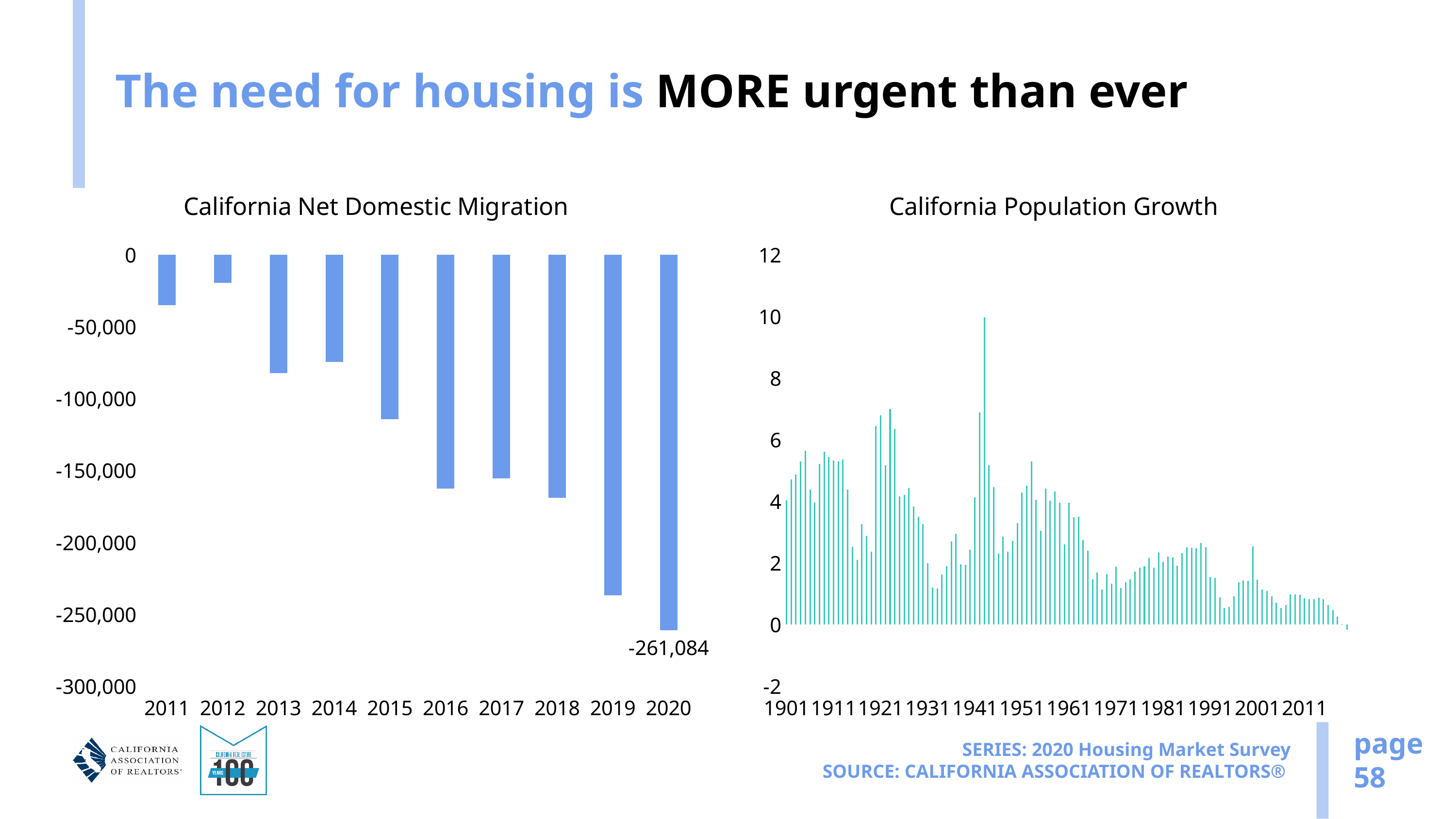
In the California Population Growth chart, is the value for 1901 greater or less than 2? greater What kind of chart is the California Population Growth chart? Bar chart In the California Net Domestic Migration chart, is the value for 2019 greater or less than -200,000? less What kind of chart is the California Net Domestic Migration chart? Bar chart What is the title of the chart on the right side of the slide? California Population Growth In the California Net Domestic Migration chart, is the value for 2013 greater or less than -100,000? greater In the California Net Domestic Migration chart, which year has the lower value, 2015 or 2016? 2016 In the California Net Domestic Migration chart, what is the value for 2020? -261,084 In the California Net Domestic Migration chart, which year has the lowest (most negative) value? 2020 In the California Net Domestic Migration chart, do the values generally rise or fall from 2011 to 2020? Fall How many years are shown in the California Net Domestic Migration chart? 10 In the California Net Domestic Migration chart, which year has the highest (least negative) value? 2012